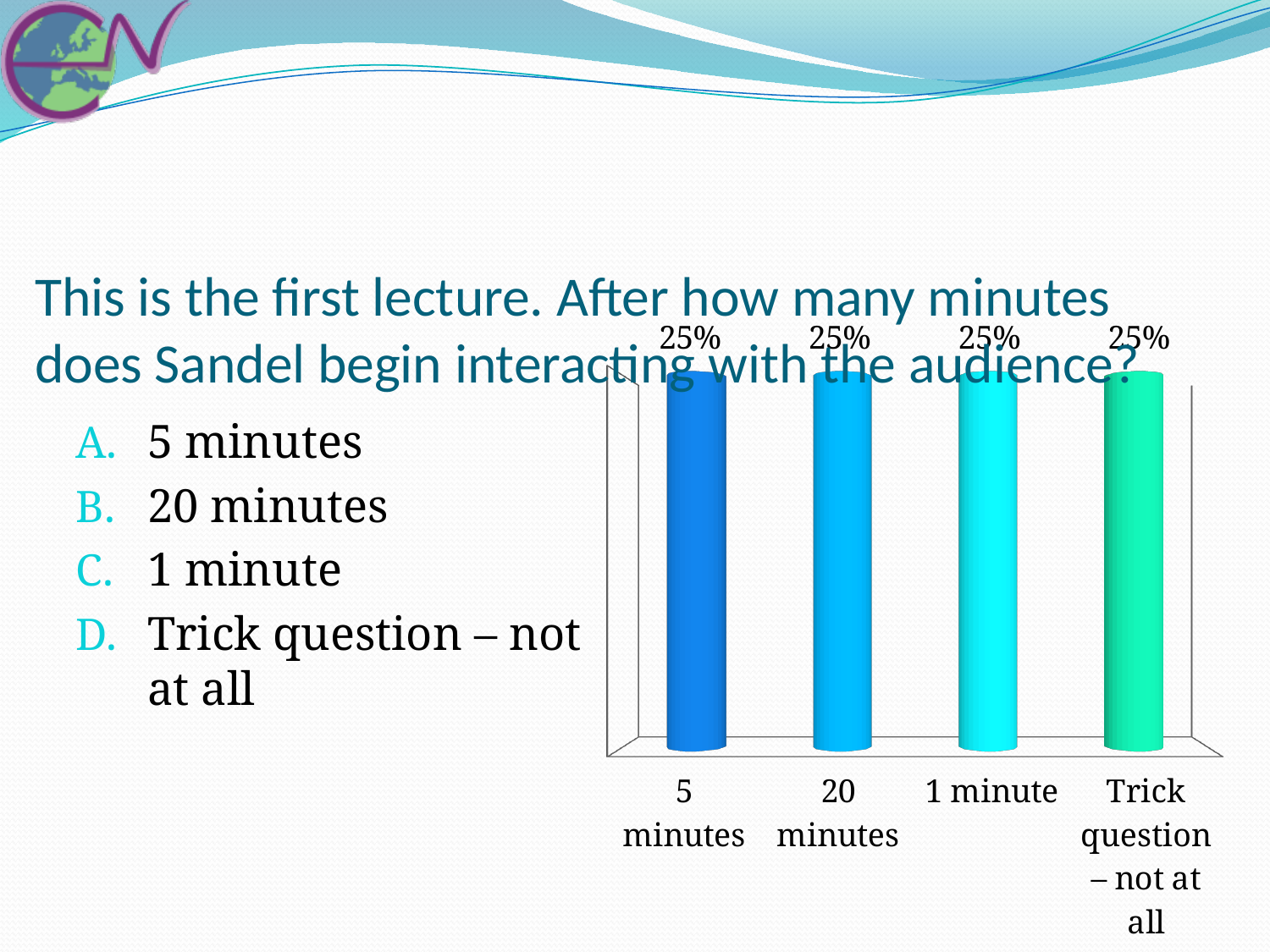
What is the label of the rightmost category on the chart? Trick question – not at all What is the difference between the values for "5 minutes" and "20 minutes"? 0% Do all four bars have the same value? Yes What is the value for the "Trick question – not at all" bar? 25% What is the difference between the values for "1 minute" and "Trick question – not at all"? 0% What kind of chart is shown on the slide? bar chart What is the value for the "20 minutes" bar? 25% What is the label of the leftmost category on the chart? 5 minutes Do the values rise, fall, or stay the same across the categories from left to right? stay the same How many categories are shown on the chart? 4 What is the value for the "5 minutes" bar? 25% What is the value for the "1 minute" bar? 25%